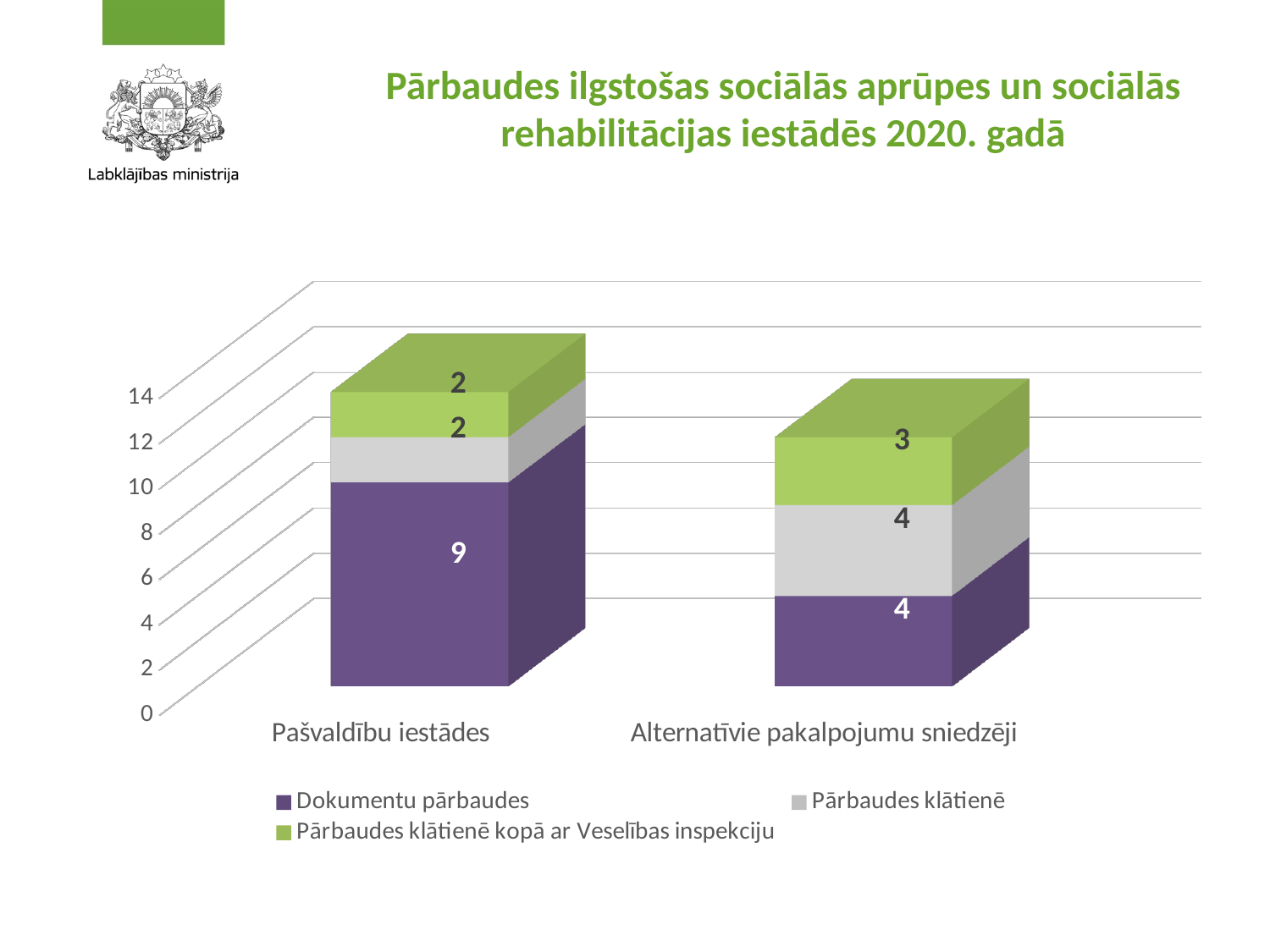
What is the total of the stacked bar for Alternatīvie pakalpojumu sniedzēji? 11 How many categories are shown on the x axis? 2 What is the value of Pārbaudes klātienē kopā ar Veselības inspekciju for Alternatīvie pakalpojumu sniedzēji? 3 What kind of chart is shown on the slide? Stacked bar chart What is the value of Pārbaudes klātienē for Alternatīvie pakalpojumu sniedzēji? 4 How many series does the legend list? 3 Which category has the higher value for Dokumentu pārbaudes? Pašvaldību iestādes What is the value of Pārbaudes klātienē for Pašvaldību iestādes? 2 Which category has the higher value for Pārbaudes klātienē kopā ar Veselības inspekciju? Alternatīvie pakalpojumu sniedzēji What is the difference between Dokumentu pārbaudes for Pašvaldību iestādes and for Alternatīvie pakalpojumu sniedzēji? 5 What is the total of the stacked bar for Pašvaldību iestādes? 13 What is the value of Dokumentu pārbaudes for Pašvaldību iestādes? 9